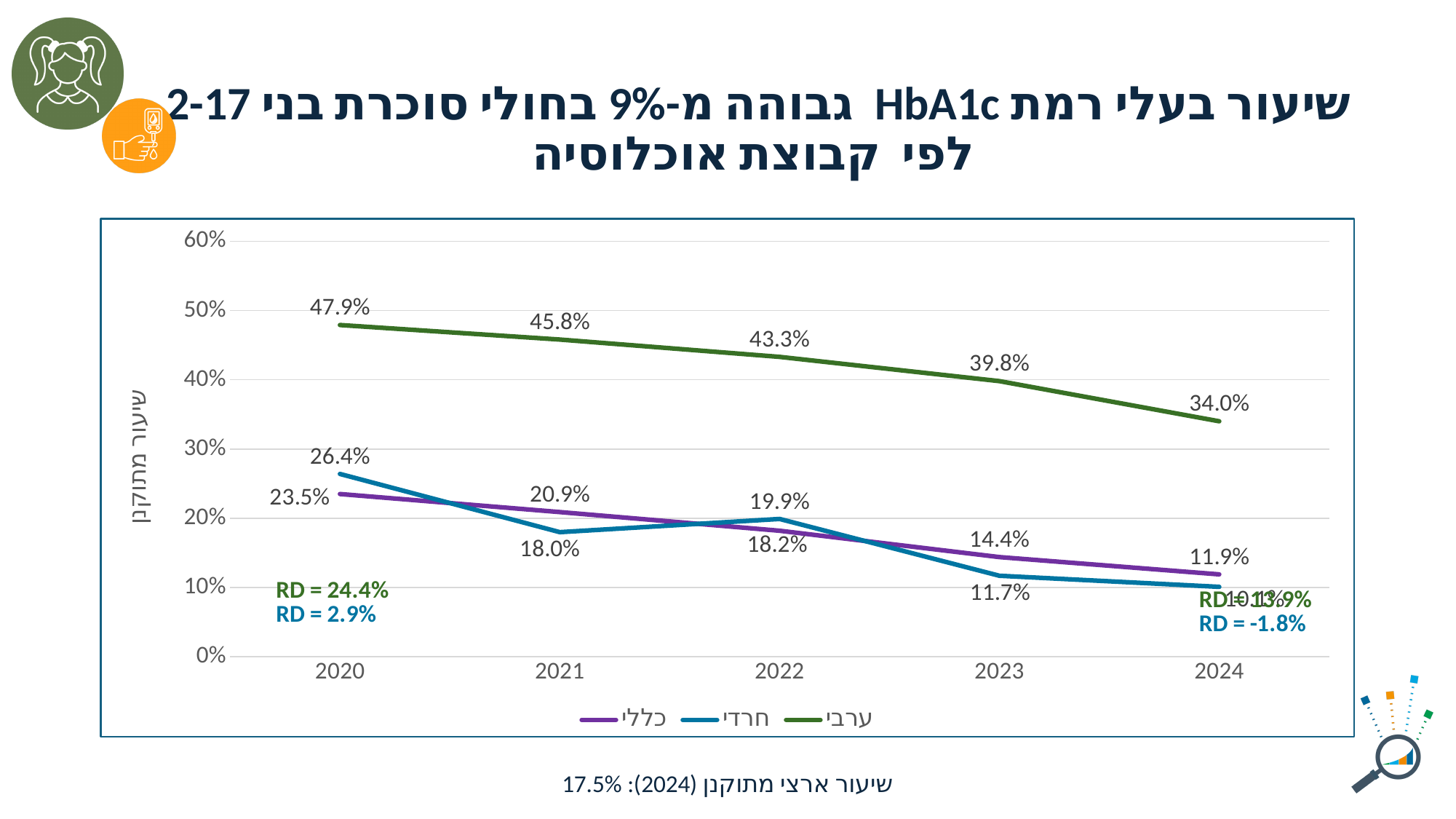
What is the value for כללי in 2022? 18.2% Is the value for ערבי in 2022 greater or less than 40%? greater What is the difference between the ערבי values in 2020 and 2024? 13.9% In 2020, which is larger: the value for חרדי or the value for כללי? חרדי What is the value for ערבי in 2020? 47.9% Which series has the highest value in 2024? ערבי How many series does the legend list? 3 What is the value for חרדי in 2021? 18.0% How many years are shown on the x axis? 5 Does the value for ערבי rise or fall from 2020 to 2024? fall What is the value for חרדי in 2023? 11.7% In which year is the value for ערבי lowest? 2024